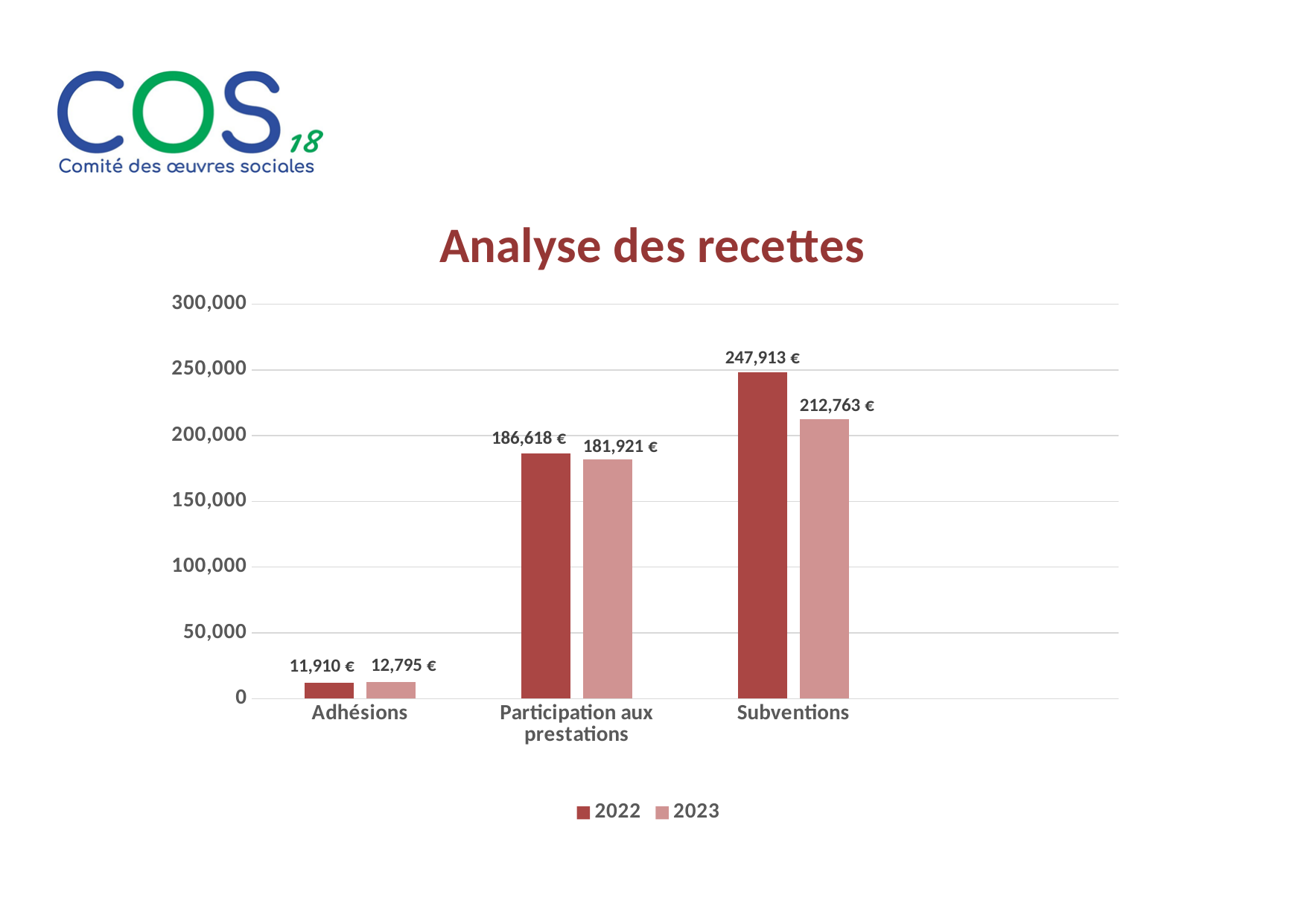
How many series does the legend list? 2 What is the difference between the 2022 and 2023 values for Subventions? 35,150 € What is the value for Adhésions in 2023? 12,795 € What is the title of the chart? Analyse des recettes Which category has the highest value in 2023? Subventions What is the value for Subventions in 2022? 247,913 € Which is larger for Adhésions: the 2022 value or the 2023 value? 2023 Is the value for Participation aux prestations in 2022 greater or less than 150,000? greater How many categories are shown on the x axis? 3 What kind of chart is shown on the slide? bar chart Which category has the lowest value in 2022? Adhésions What is the value for Participation aux prestations in 2023? 181,921 €